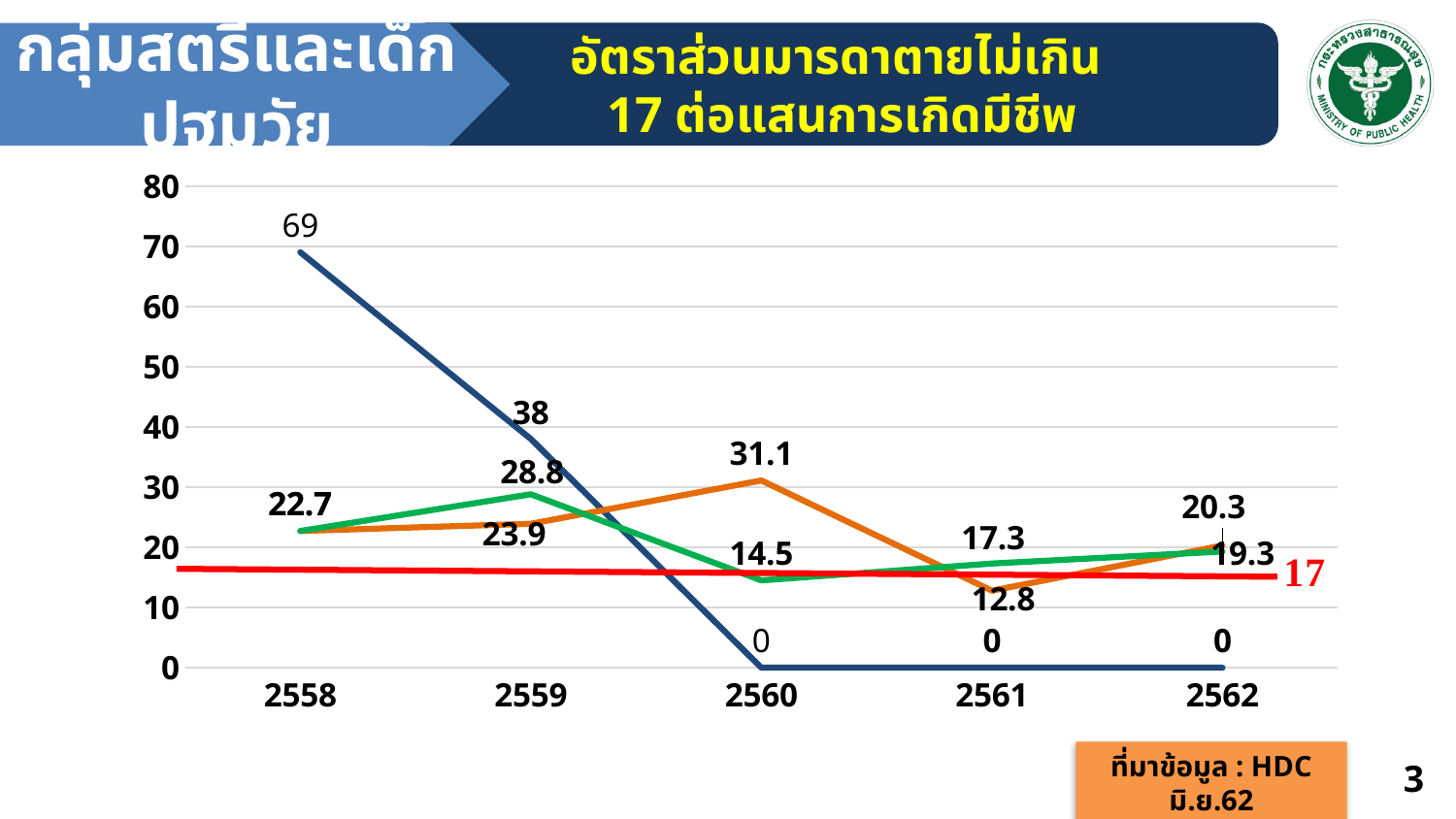
What is the value of the dark blue line in 2560? 0 What is the value of the orange line in 2561? 12.8 What kind of chart is shown on the slide? line chart What is the value of the orange line in 2560? 31.1 How many years are shown on the x axis of the chart? 5 What value is labelled on the red horizontal line? 17 In 2560, which line has the higher value, the orange line or the green line? orange line What is the value of the dark blue line in 2559? 38 What is the value of the dark blue line in 2558? 69 What is the value of the green line in 2561? 17.3 By how much does the dark blue line fall from 2558 to 2559? 31 In which year does the dark blue line reach its highest value? 2558